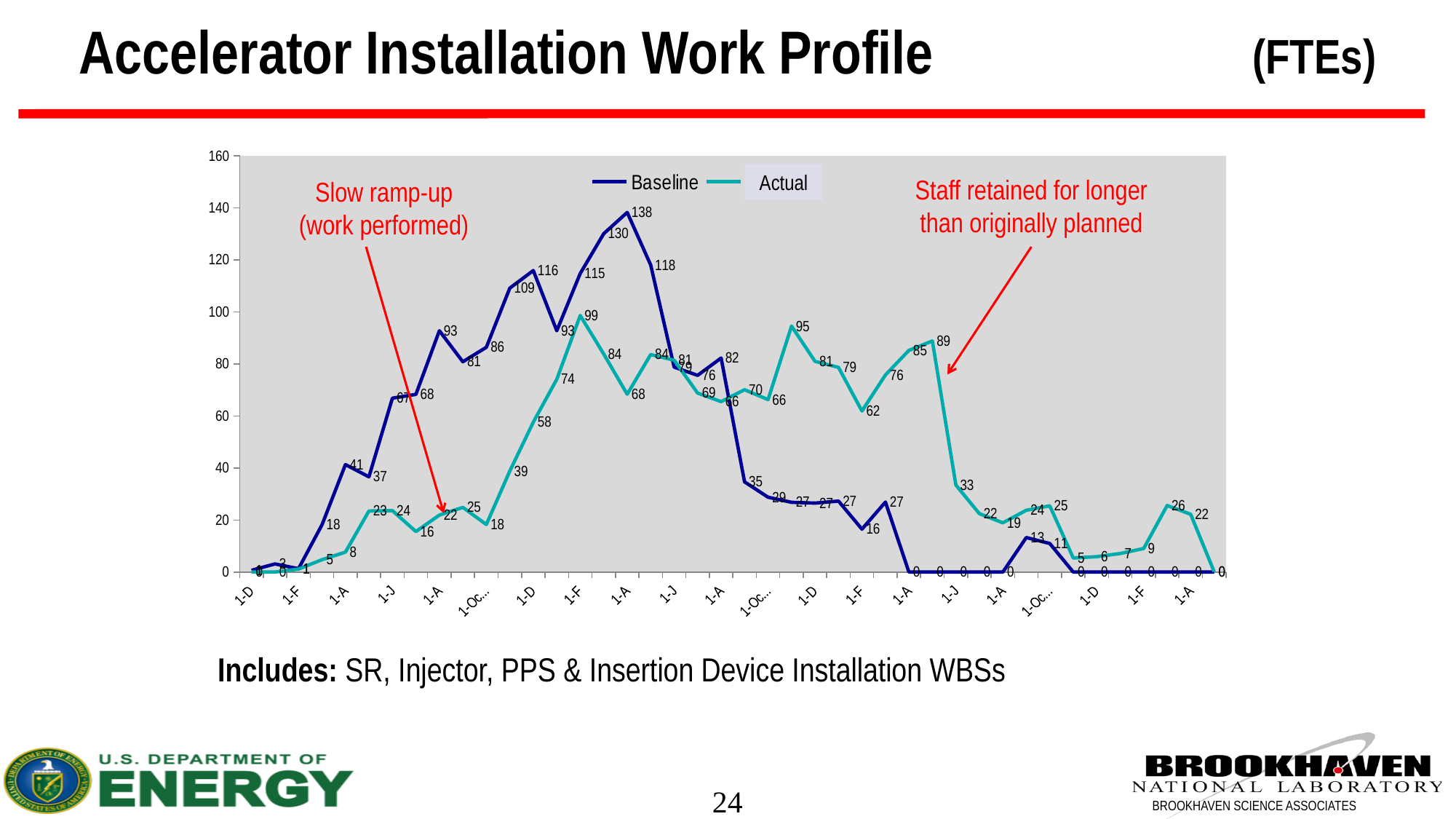
What is the highest value labeled on the Baseline line? 138 What kind of chart is shown on the slide? line chart What are the two series named in the chart legend? Baseline and Actual What is the highest value labeled on the Actual line? 99 What is the maximum value shown on the chart's vertical axis? 160 Is the peak value of the Actual line greater or less than 80? greater Is the peak value of the Baseline line greater or less than 120? greater What value do both the Baseline and Actual lines end at on the far right of the chart? 0 Which series reaches the higher peak value, Baseline or Actual? Baseline In what units are the values in the chart expressed, according to the slide title? FTEs What is the difference between the peak value of the Baseline line (138) and the peak value of the Actual line (99)? 39 How many series does the chart legend list? 2